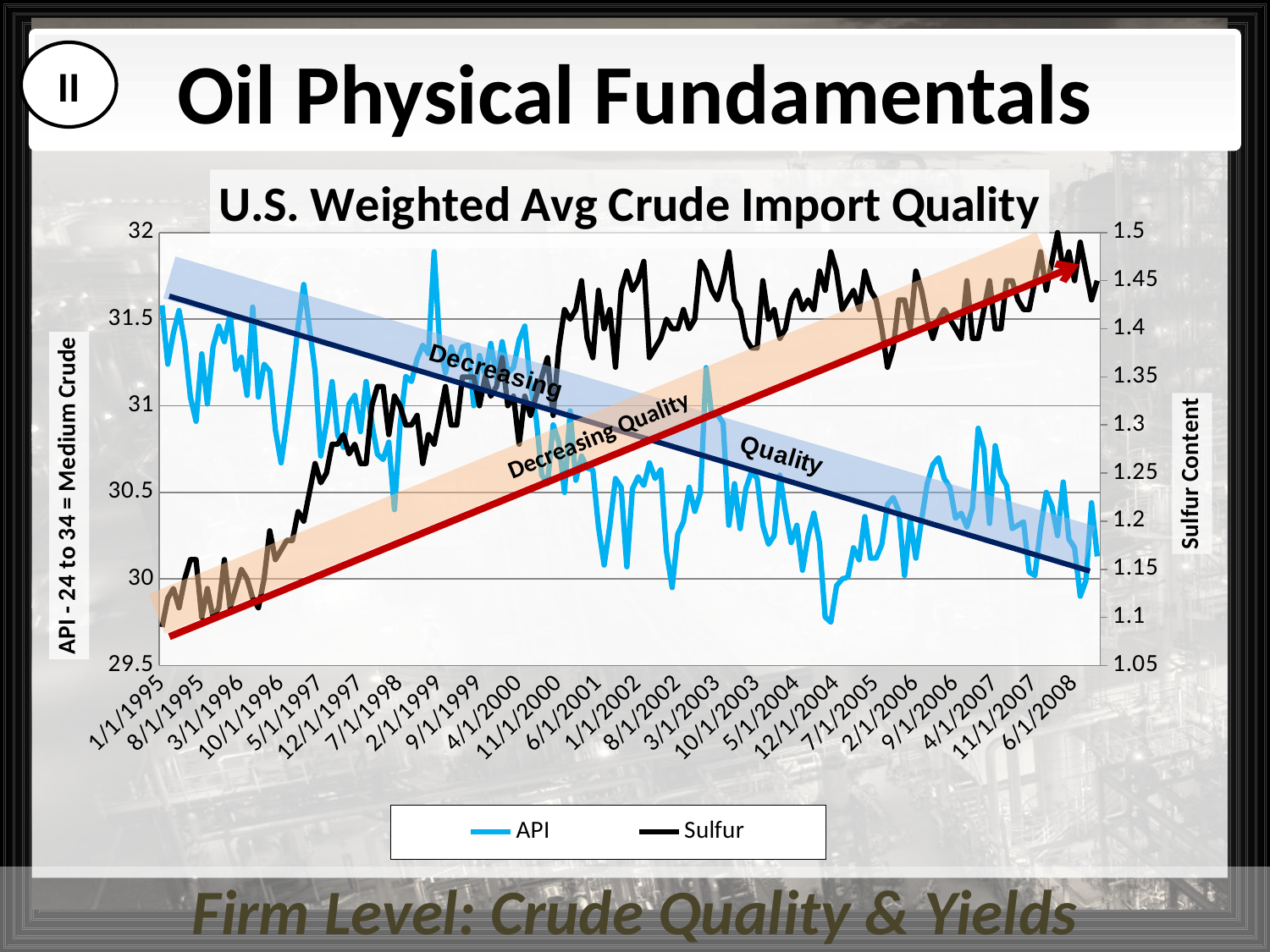
What are the two series named in the legend? API and Sulfur Does the Sulfur series rise or fall over time along the x axis? Rise What is the title of the chart? U.S. Weighted Avg Crude Import Quality Is the API value at 1/1/1995 greater or less than 31? greater Is the API value at 6/1/2008 greater or less than 30.5? less What kind of chart is shown on the slide? Line chart Is the Sulfur value at 1/1/1995 greater or less than 1.2? less Which series is plotted in blue? API How many series does the legend list? 2 Does the API series rise or fall over time along the x axis? Fall